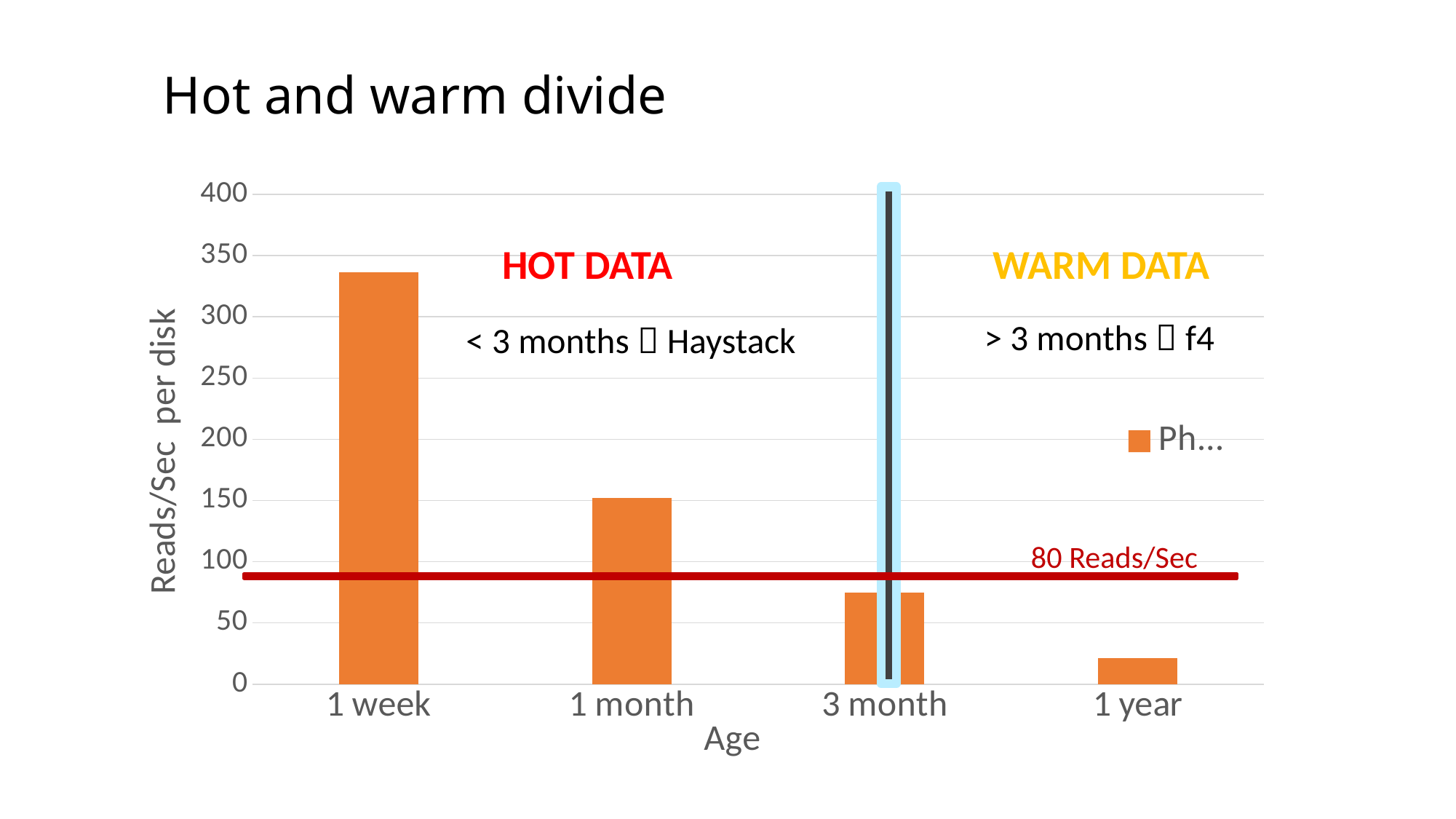
What kind of chart is shown on the slide? bar chart How many age categories are plotted on the x axis? 4 Do the values rise or fall as age increases along the x axis? fall Which age category has the lowest reads per second per disk? 1 year Is the value for 1 month greater or less than 200? less Which has a higher value, 1 month or 3 month? 1 month Which age category has the highest reads per second per disk? 1 week What value does the horizontal red line mark? 80 Reads/Sec Is the value for 1 year greater or less than 50? less What is the title of the y axis? Reads/Sec per disk Is the value for 1 week greater or less than 300? greater